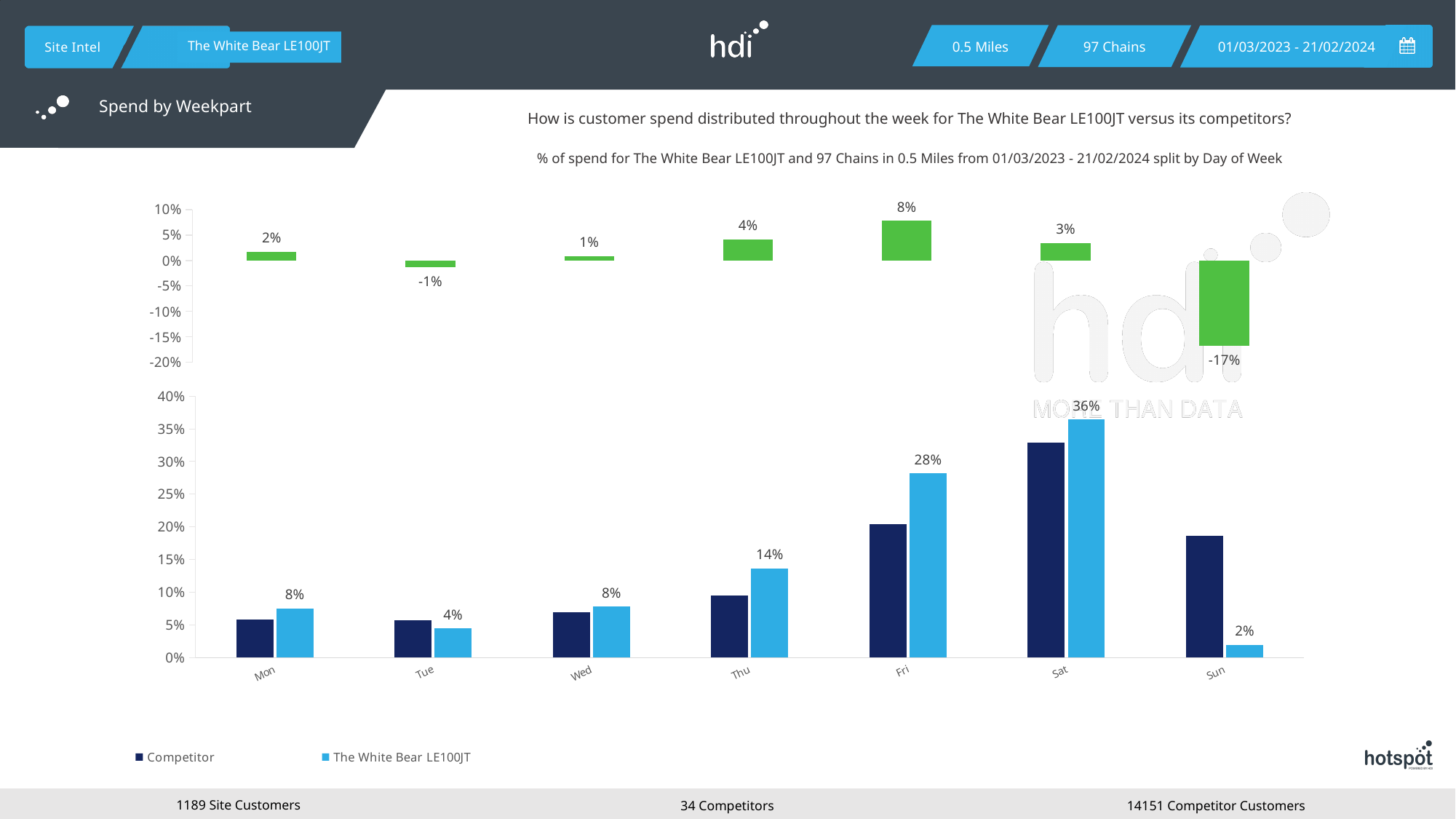
In the bottom chart, which is larger on Sun: the Competitor bar or The White Bear LE100JT bar? Competitor In the bottom chart, how many days are shown on the x axis? 7 In the bottom chart, what is the value for The White Bear LE100JT on Sat? 36% In the top chart (green bars), which day has the lowest value? Sun In the top chart (green bars), what is the value for Sun? -17% How many series does the legend of the bottom chart list? 2 In the bottom chart, is the Competitor value for Sat greater or less than 30%? greater What kind of chart is the bottom chart? Bar chart In the bottom chart, what is the difference between The White Bear LE100JT values for Sat and Fri? 8% In the bottom chart, what is the value for The White Bear LE100JT on Thu? 14% In the bottom chart, on which day is The White Bear LE100JT value highest? Sat In the top chart (green bars), what is the value for Fri? 8%